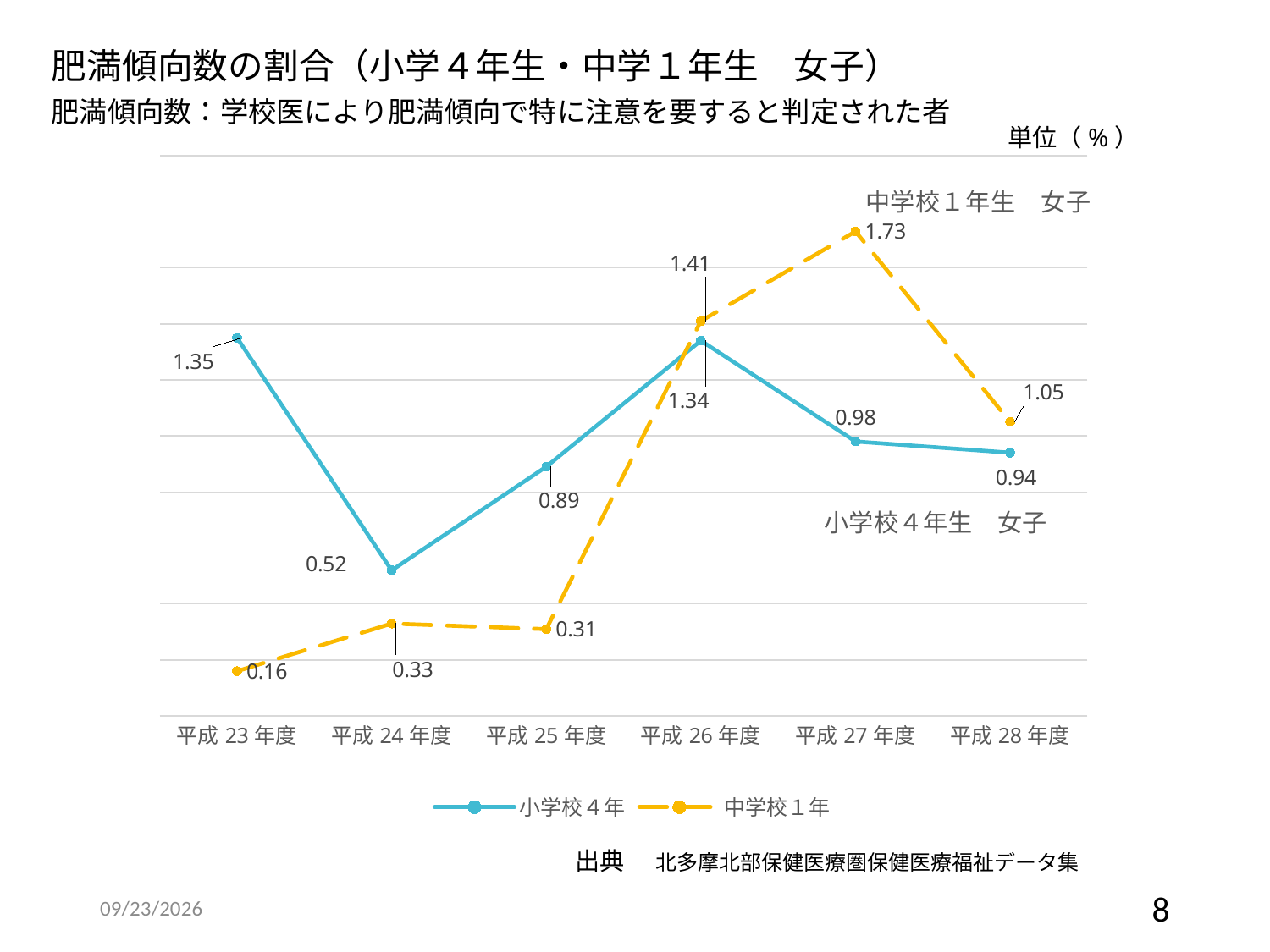
What is the value for 中学校1年 in 平成23年度? 0.16 How many series does the legend list? 2 What is the value for 小学校4年 in 平成23年度? 1.35 How many fiscal years are plotted along the x axis? 6 Which series has the larger value in 平成25年度, 小学校4年 or 中学校1年? 小学校4年 In which fiscal year is the 小学校4年 value lowest? 平成24年度 In which fiscal year is the 中学校1年 value highest? 平成27年度 What unit is indicated for the values in the chart? % What type of chart is shown on the slide? line chart Does the 中学校1年 value rise or fall from 平成27年度 to 平成28年度? fall What is the value for 中学校1年 in 平成27年度? 1.73 What is the difference between the 中学校1年 value and the 小学校4年 value in 平成27年度? 0.75